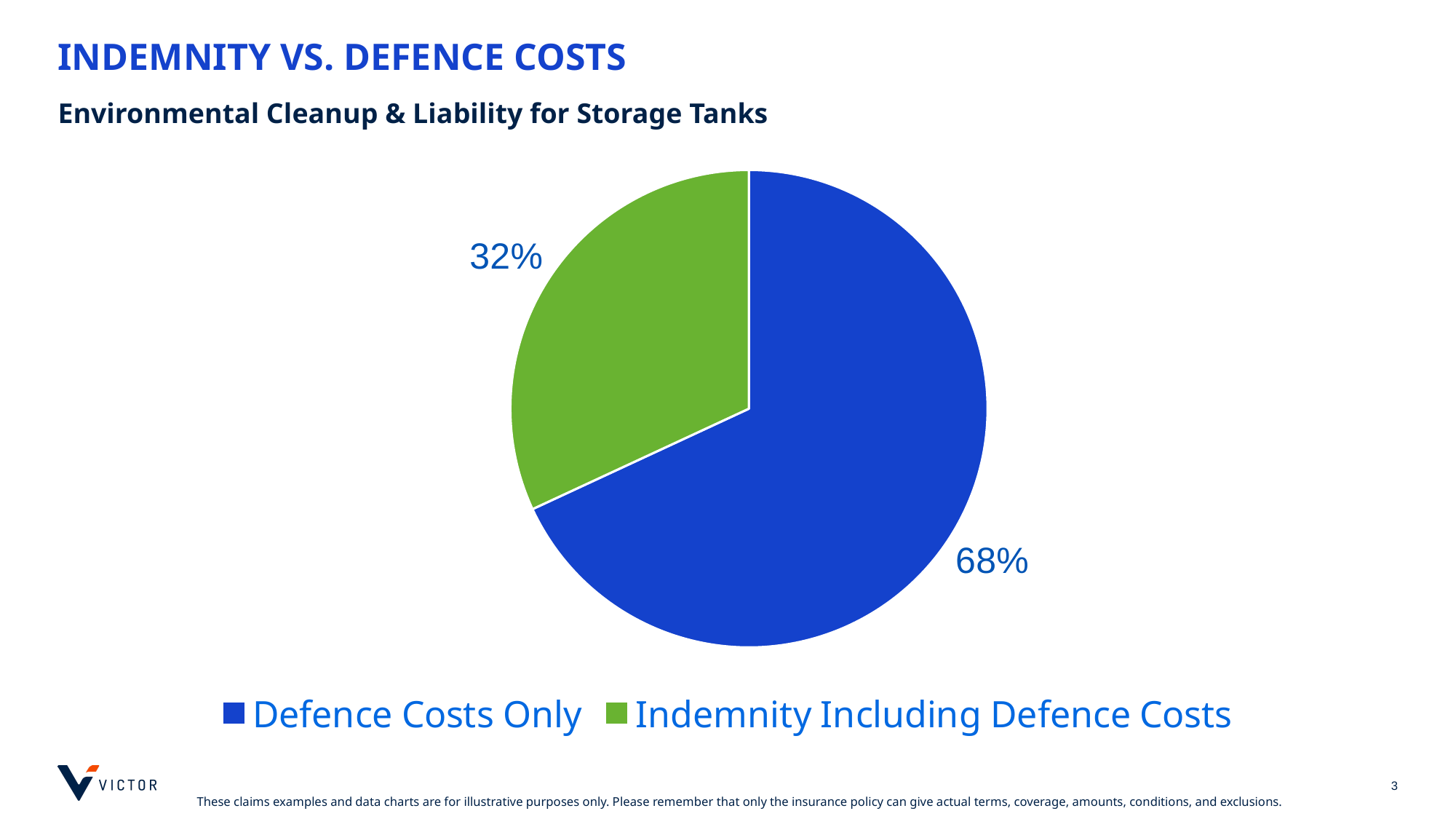
What is the difference in percentage points between Defence Costs Only and Indemnity Including Defence Costs? 36 How many entries does the legend list? 2 Which slice of the pie is the largest? Defence Costs Only What percentage of the pie is Defence Costs Only? 68% Which slice of the pie is the smallest? Indemnity Including Defence Costs What kind of chart is shown on the slide? Pie chart How many slices does the pie chart have? 2 What percentage of the pie is Indemnity Including Defence Costs? 32% What colour is the Defence Costs Only slice? Blue What share of the pie does the green slice represent? 32% Which is larger: Defence Costs Only or Indemnity Including Defence Costs? Defence Costs Only What is the subtitle shown above the chart? Environmental Cleanup & Liability for Storage Tanks